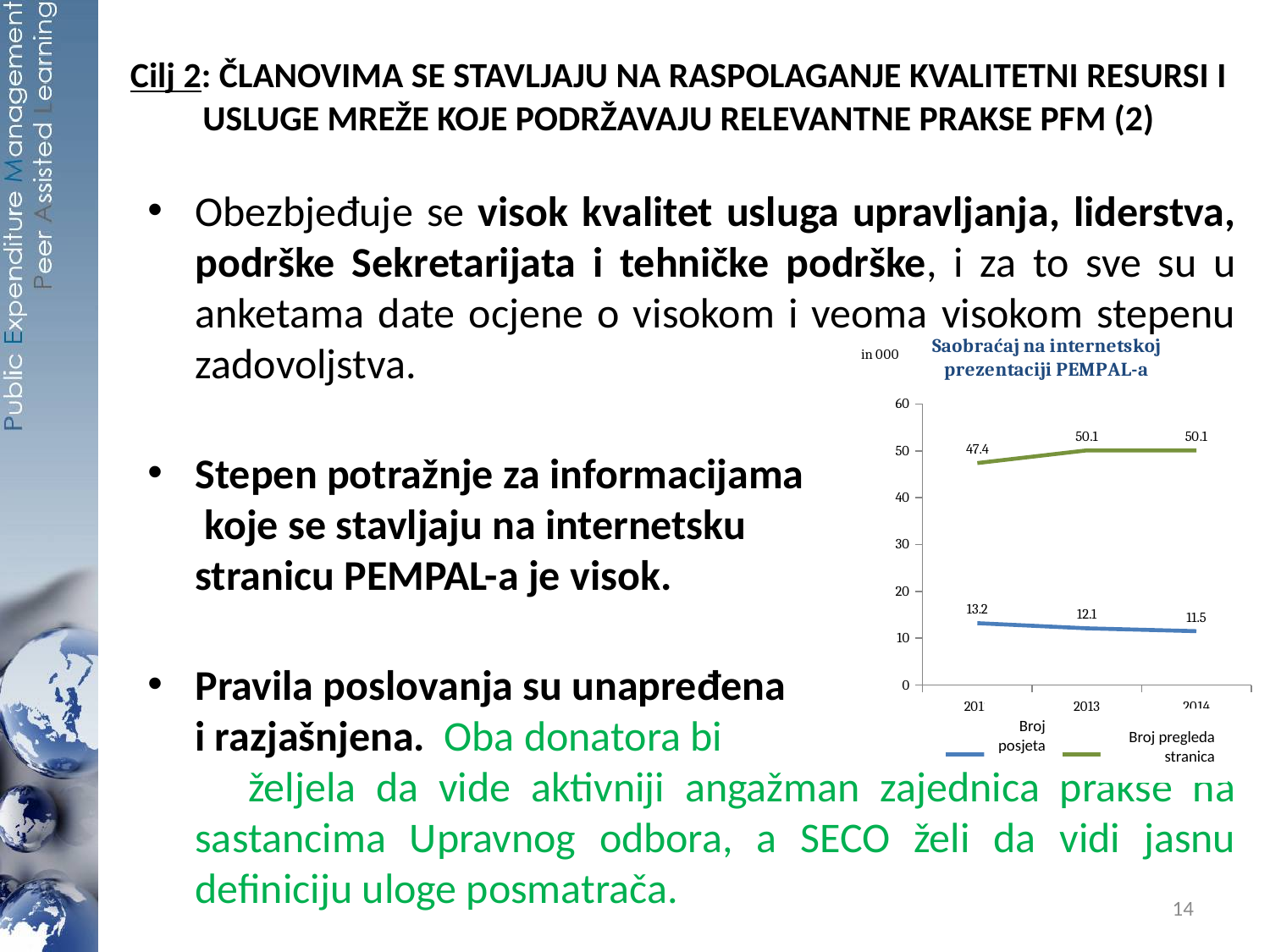
What is the title of the chart on the slide? Saobraćaj na internetskoj prezentaciji PEMPAL-a What is the value of Broj posjeta in 2013? 12.1 What is the first plotted value of the Broj pregleda stranica series? 47.4 What type of chart is shown on the slide? line chart What is the first plotted value of the Broj posjeta series? 13.2 What is the difference between Broj pregleda stranica and Broj posjeta in 2013? 38.0 How many series does the chart legend list? 2 What is the last plotted value of the Broj posjeta series? 11.5 How many data points are plotted for the Broj posjeta series? 3 Does the Broj posjeta series rise or fall along the x axis? fall Which series has the higher value in 2013, Broj posjeta or Broj pregleda stranica? Broj pregleda stranica What is the value of Broj pregleda stranica in 2013? 50.1